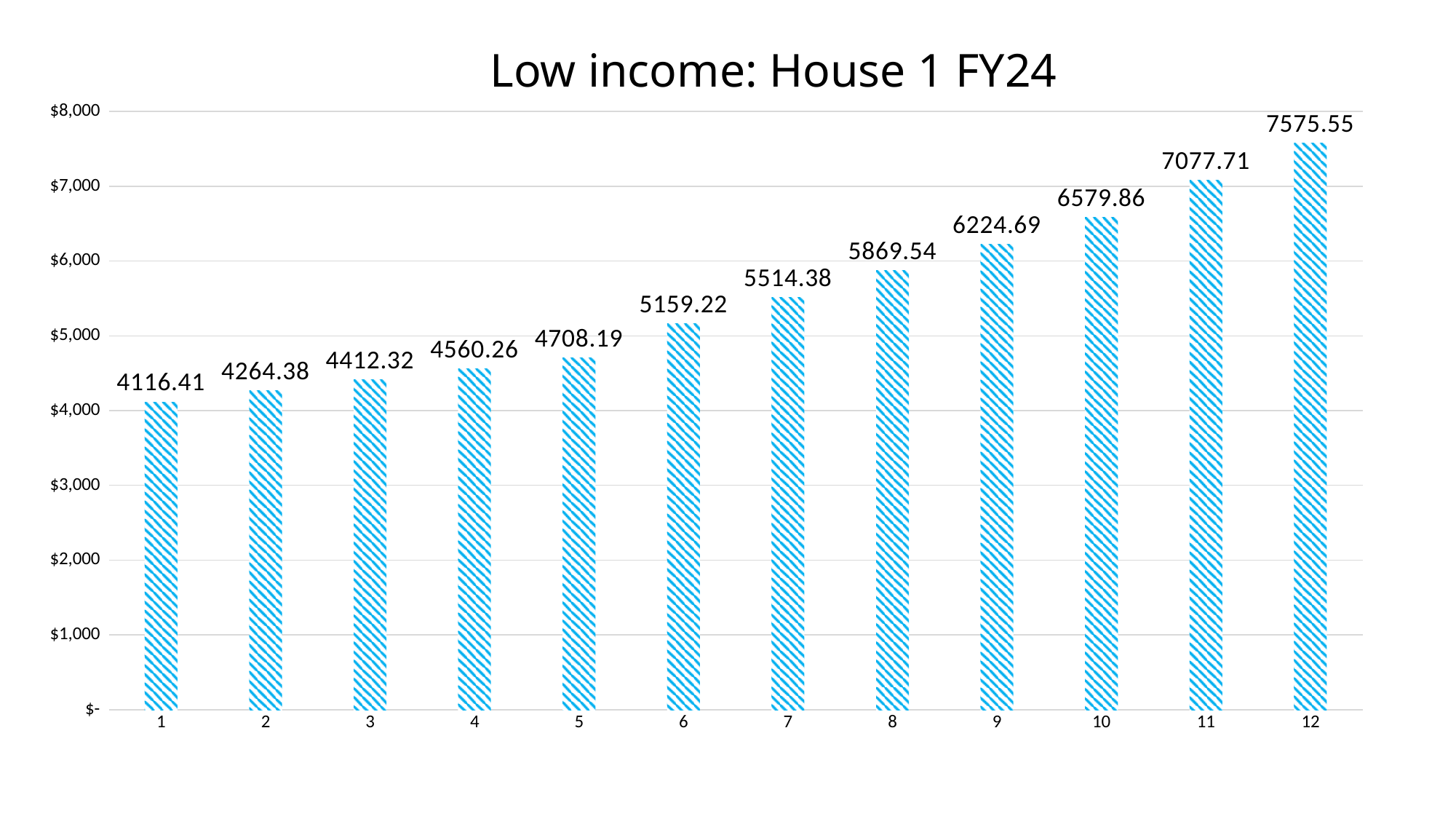
Is the value for category 10 greater or less than $6,000? greater Which is larger, the value for category 9 or the value for category 6? 9 What is the difference between the values for category 12 and category 11? 497.84 What is the value for category 7? 5514.38 Do the values rise or fall from category 1 to category 12? rise Which category has the lowest value? 1 Which category has the highest value? 12 What kind of chart is this? bar chart What is the value for category 1? 4116.41 How many bars are shown in the chart? 12 What is the difference between the values for category 2 and category 1? 147.97 What is the value for category 12? 7575.55